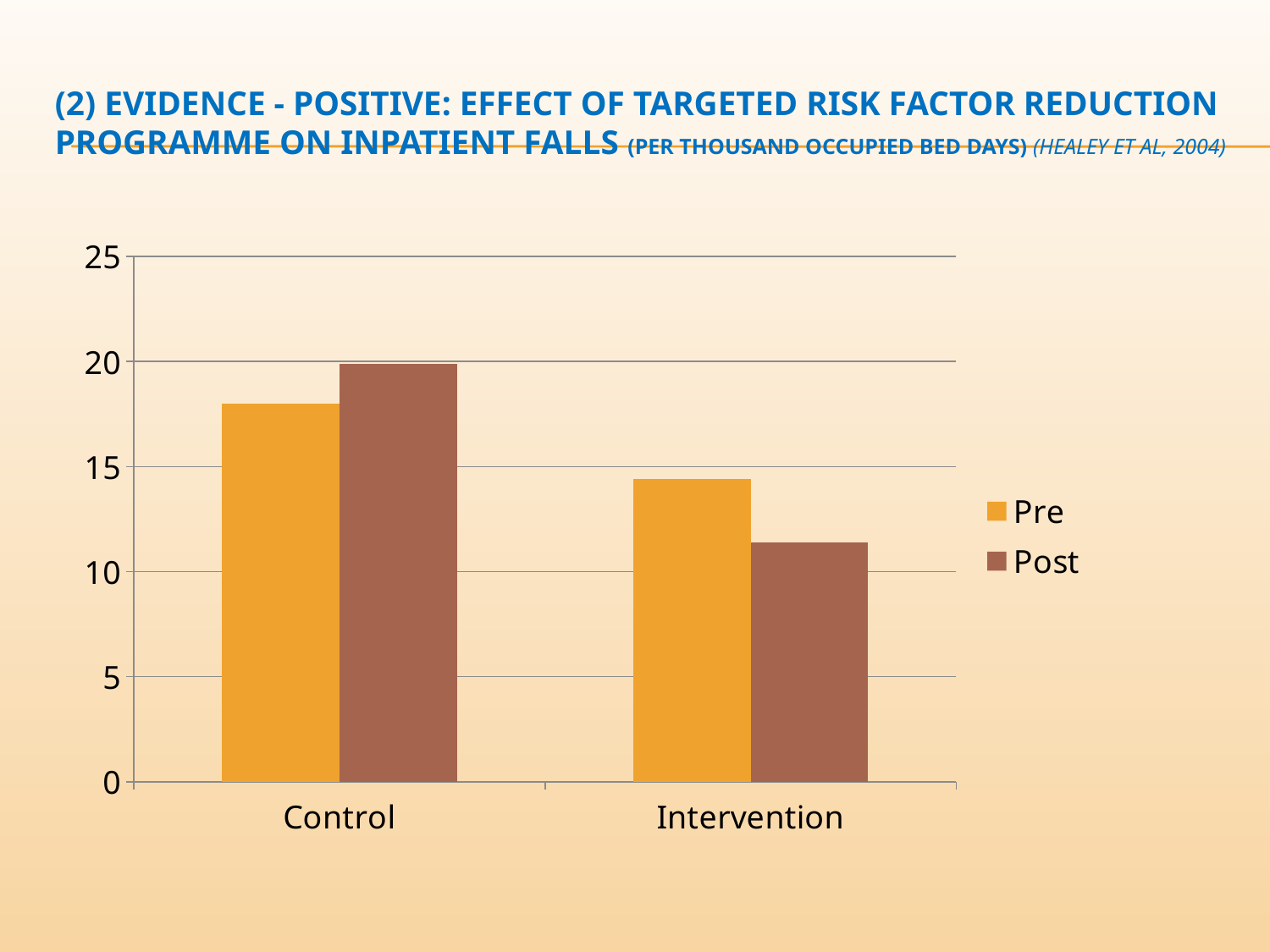
For Control, which is larger, the Pre value or the Post value? Post For Intervention, which is larger, the Pre value or the Post value? Pre Is the Post value for Intervention greater or less than 15? less Is the Pre value for Control greater or less than 15? greater How many series does the legend list? 2 Which category and series has the lowest bar? Intervention, Post Is the Post value for Control greater or less than 15? greater How many categories are shown on the x axis? 2 What are the two entries listed in the legend? Pre and Post What kind of chart is shown on the slide? bar chart Which category and series has the highest bar? Control, Post